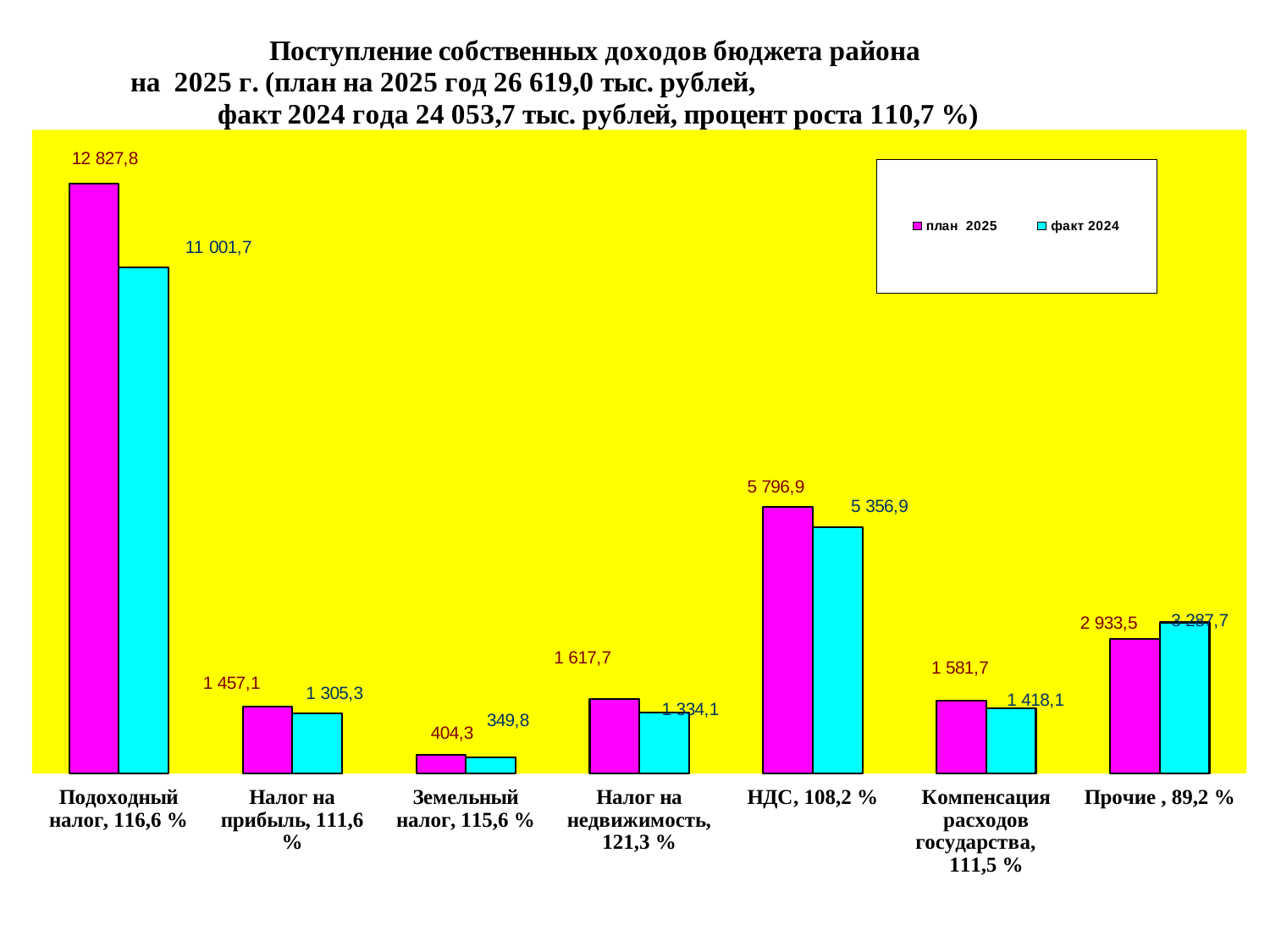
For Прочие, which is larger: план 2025 or факт 2024? факт 2024 What is the факт 2024 value for Компенсация расходов государства? 1 418,1 Which category has the highest план 2025 value? Подоходный налог What is the план 2025 value for Подоходный налог? 12 827,8 Which category has the lowest факт 2024 value? Земельный налог What is the факт 2024 value for НДС? 5 356,9 What is the план 2025 value for Земельный налог? 404,3 How many series does the legend list? 2 Which colour represents the факт 2024 series? cyan What kind of chart is shown on the slide? bar chart How many categories are shown on the x axis? 7 What is the difference between the план 2025 and факт 2024 values for НДС? 440,0